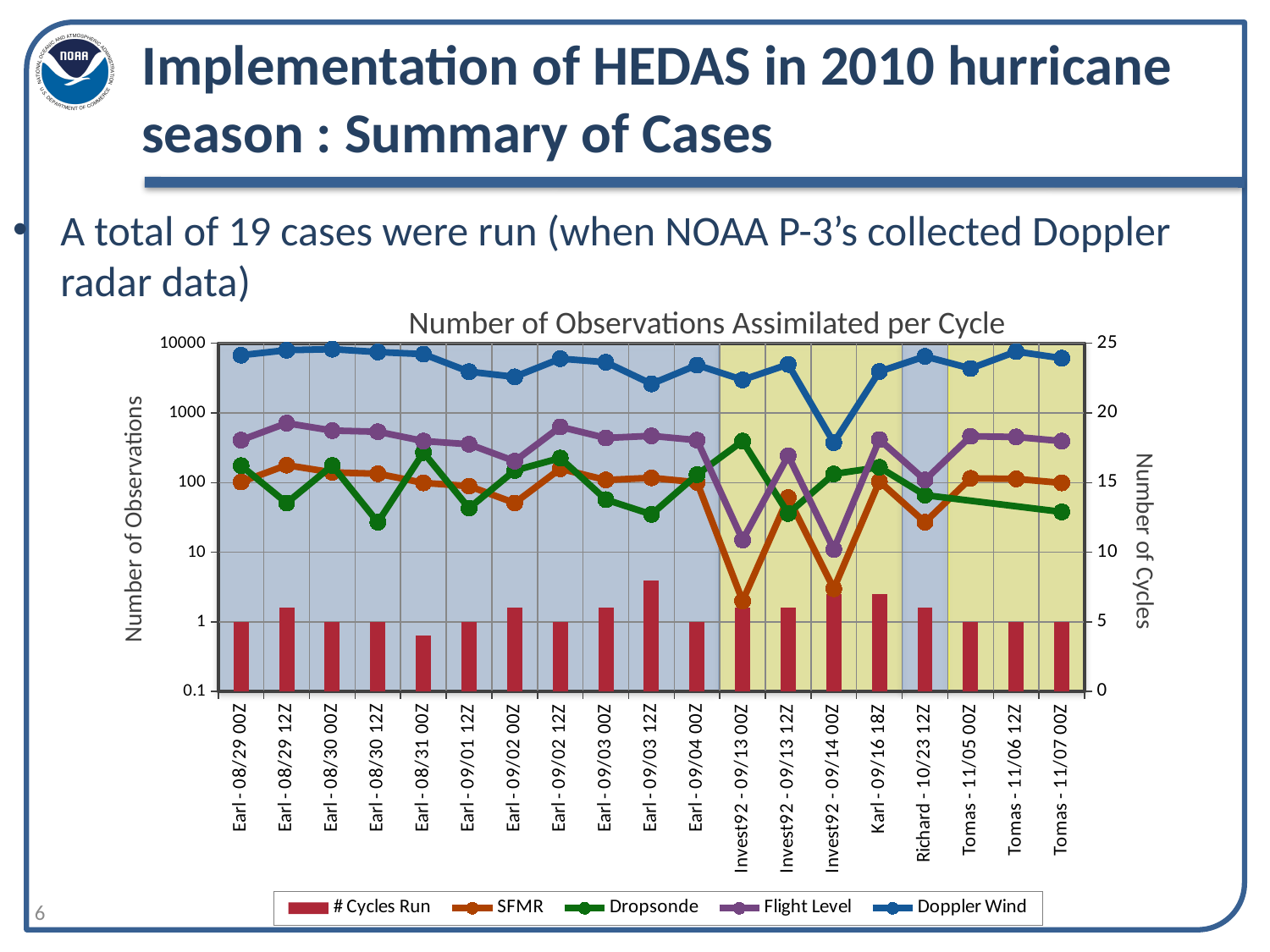
Which case has the lowest SFMR value? Invest92 - 09/13 00Z Is the Dropsonde value for Earl - 08/30 12Z greater or less than 100? less How many cases (categories) are shown along the x axis of the chart? 19 Which case has the tallest # Cycles Run bar? Earl - 09/03 12Z Which case has the lowest Doppler Wind value? Invest92 - 09/14 00Z What is the title of the chart? Number of Observations Assimilated per Cycle Which case has the shortest # Cycles Run bar? Earl - 08/31 00Z What is the label of the right-hand vertical axis? Number of Cycles For Earl - 08/30 12Z, which is larger: the SFMR value or the Dropsonde value? SFMR What kind of chart is shown on the slide? Combined bar and line chart Is the Doppler Wind value for Earl - 08/29 00Z greater or less than 1000? greater How many series does the chart legend list? 5